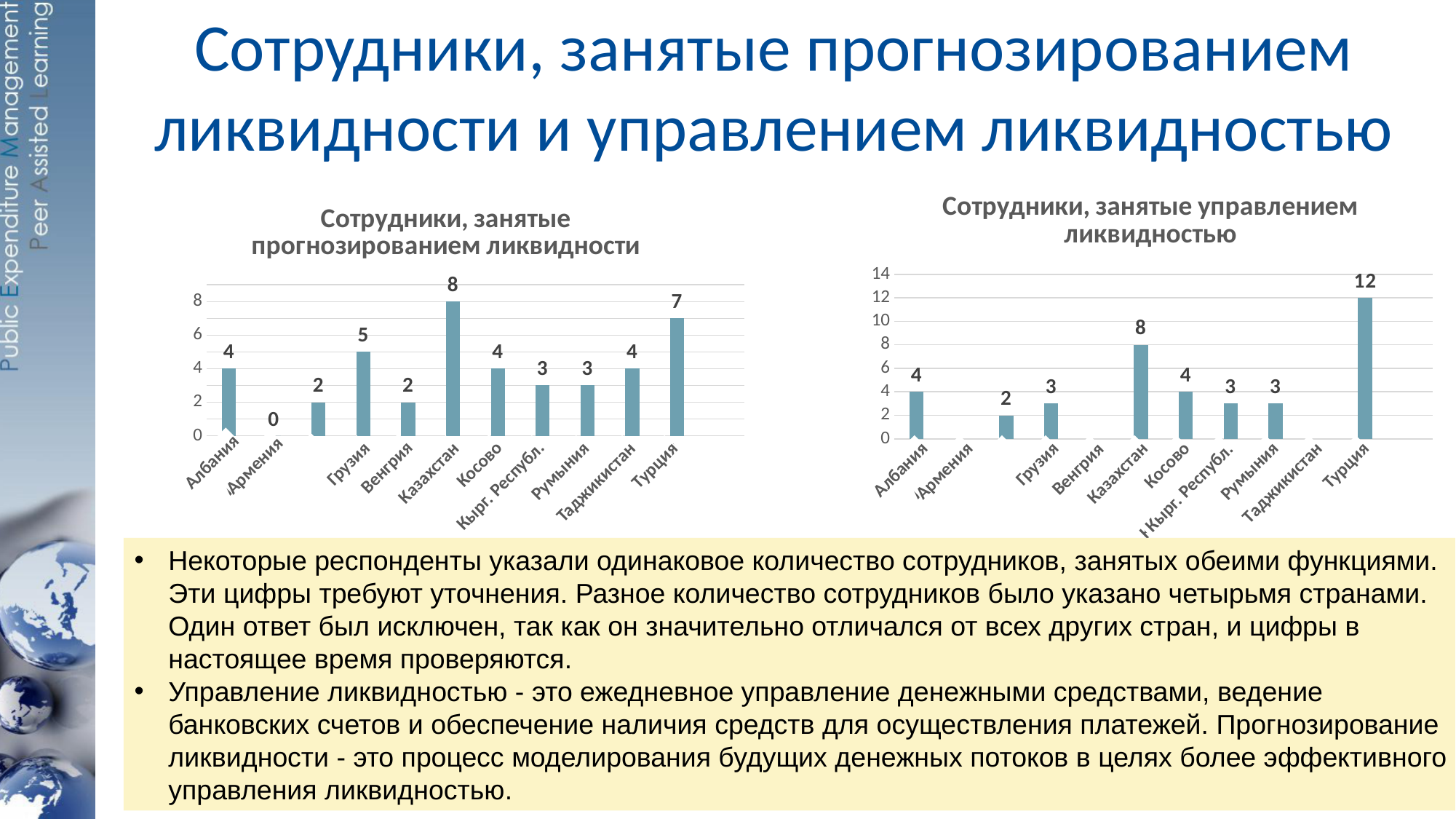
In the chart 'Сотрудники, занятые прогнозированием ликвидности', what is the value for Турция? 7 In the chart 'Сотрудники, занятые управлением ликвидностью', what is the difference between Турция and Албания? 8 In the chart 'Сотрудники, занятые управлением ликвидностью', which is larger: the value for Турция or the value for Казахстан? Турция What type of chart is used for 'Сотрудники, занятые прогнозированием ликвидности'? Bar chart In the chart 'Сотрудники, занятые прогнозированием ликвидности', what is the value for Армения? 0 In the chart 'Сотрудники, занятые управлением ликвидностью', which country has the highest value? Турция In the chart 'Сотрудники, занятые управлением ликвидностью', what is the value for Казахстан? 8 In the chart 'Сотрудники, занятые прогнозированием ликвидности', which country has the highest value? Казахстан In the chart 'Сотрудники, занятые управлением ликвидностью', what is the value for Турция? 12 What is the highest tick on the vertical axis of the chart 'Сотрудники, занятые управлением ликвидностью'? 14 In the chart 'Сотрудники, занятые прогнозированием ликвидности', what is the value for Казахстан? 8 In the chart 'Сотрудники, занятые прогнозированием ликвидности', what is the difference between Казахстан and Турция? 1